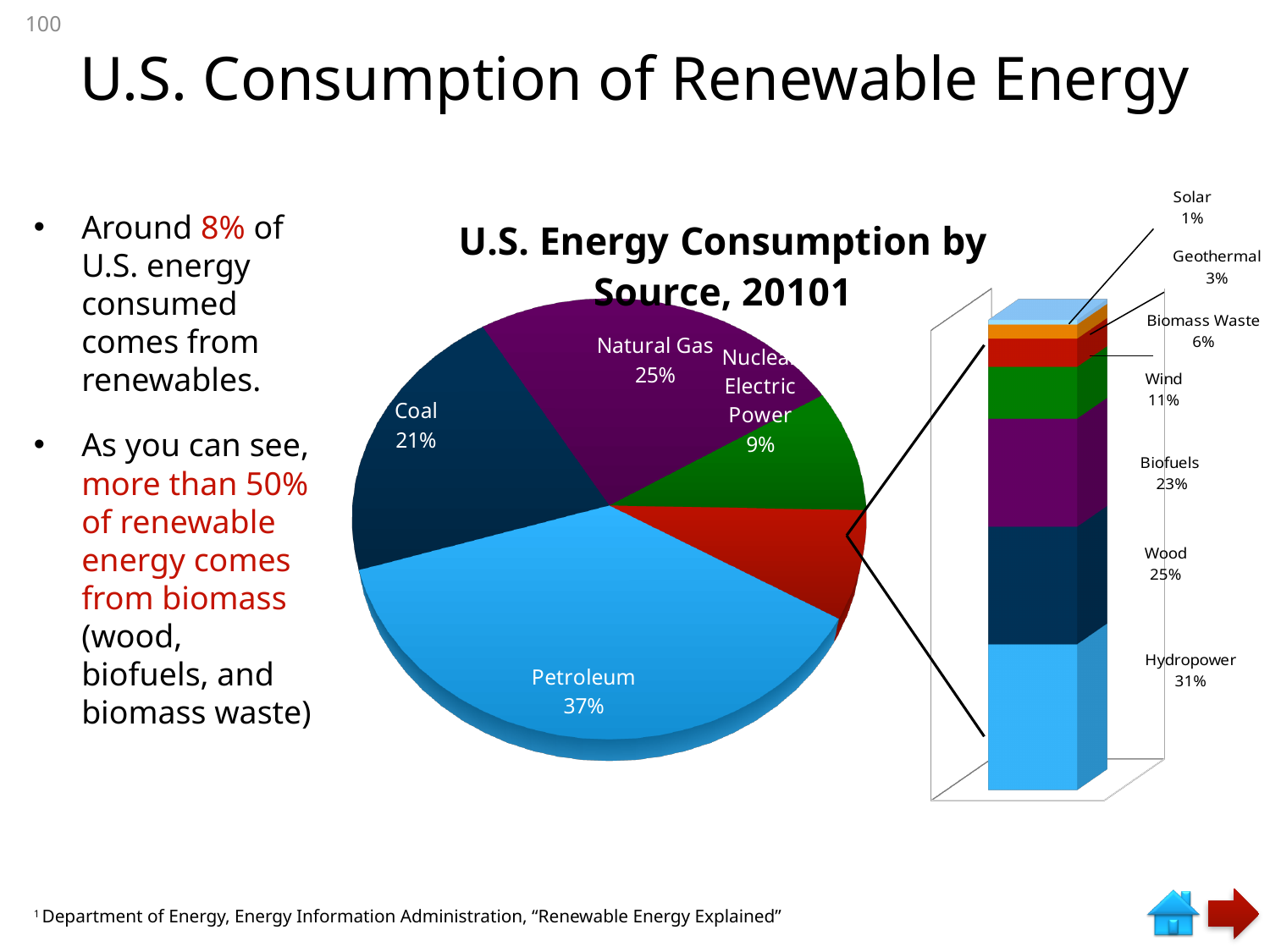
In the pie chart, what percentage of U.S. energy consumption comes from Coal? 21% What kind of chart is the chart in the centre of the slide? Pie chart How many segments are shown in the stacked bar on the right? 7 In the stacked bar on the right, what percentage of renewable energy comes from Hydropower? 31% In the pie chart, what percentage of U.S. energy consumption comes from Petroleum? 37% In the pie chart, which energy source has the largest share? Petroleum In the stacked bar on the right, which renewable source has the smallest share? Solar In the pie chart, which is larger, the share for Natural Gas or the share for Coal? Natural Gas In the pie chart, what is the difference in percentage points between Petroleum and Nuclear Electric Power? 28 percentage points In the stacked bar on the right, what is the difference in percentage points between Wood and Biofuels? 2 percentage points In the stacked bar on the right, which renewable source has the largest share? Hydropower In the stacked bar on the right, which is larger, the share for Wind or the share for Biomass Waste? Wind